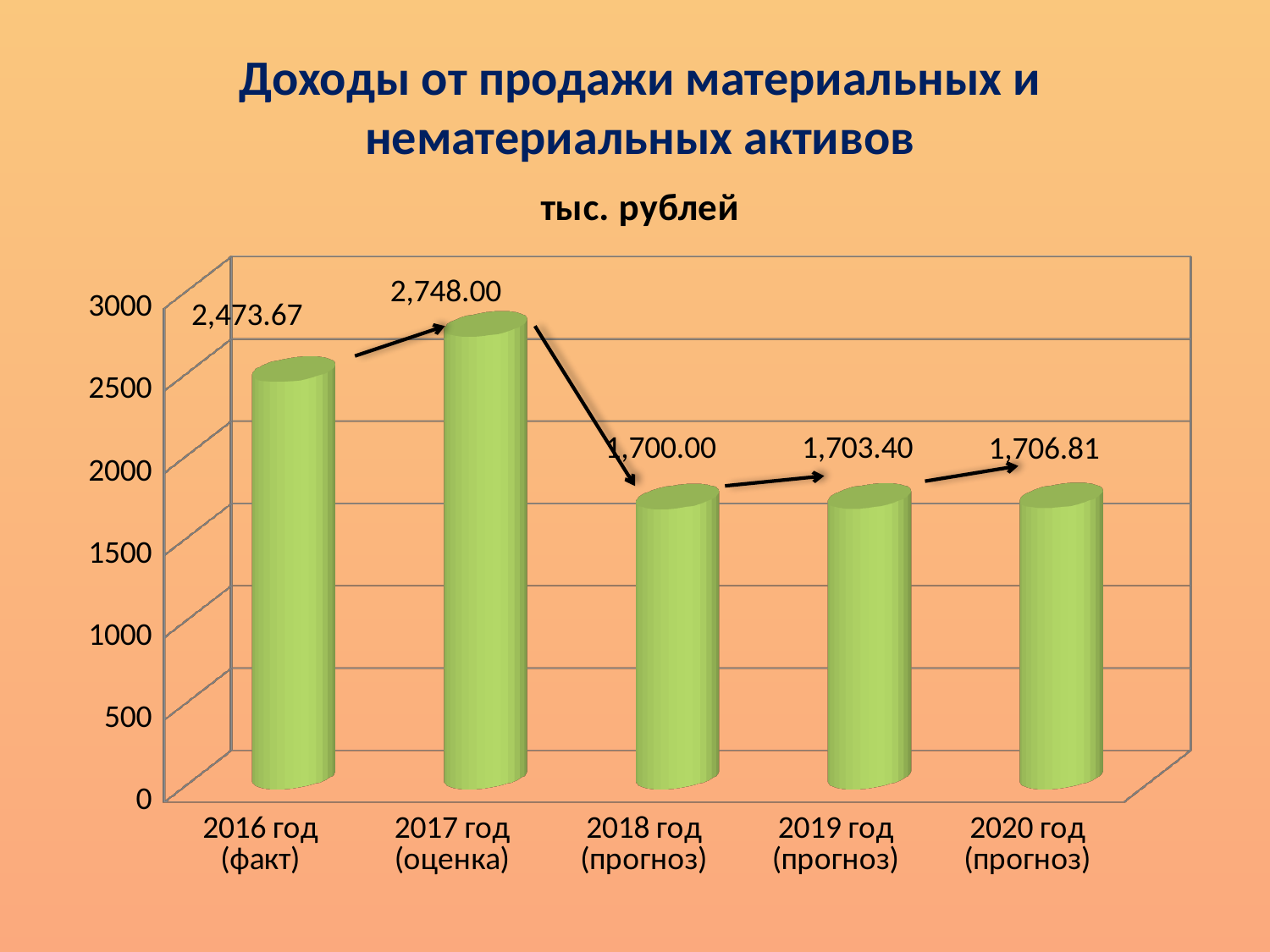
Which year has the lowest value? 2018 год (прогноз) What is the difference between the values for 2017 год (оценка) and 2016 год (факт)? 274.33 What is the value for 2019 год (прогноз)? 1,703.40 What is the value for 2017 год (оценка)? 2,748.00 Which is larger, the value for 2016 год (факт) or the value for 2020 год (прогноз)? 2016 год (факт) Which year has the highest value? 2017 год (оценка) What is the value for 2016 год (факт)? 2,473.67 How many years are shown on the chart? 5 What is the value for 2020 год (прогноз)? 1,706.81 Is the value for 2018 год (прогноз) greater or less than 2000? less What kind of chart is shown on the slide? bar chart What is the difference between the values for 2017 год (оценка) and 2018 год (прогноз)? 1,048.00